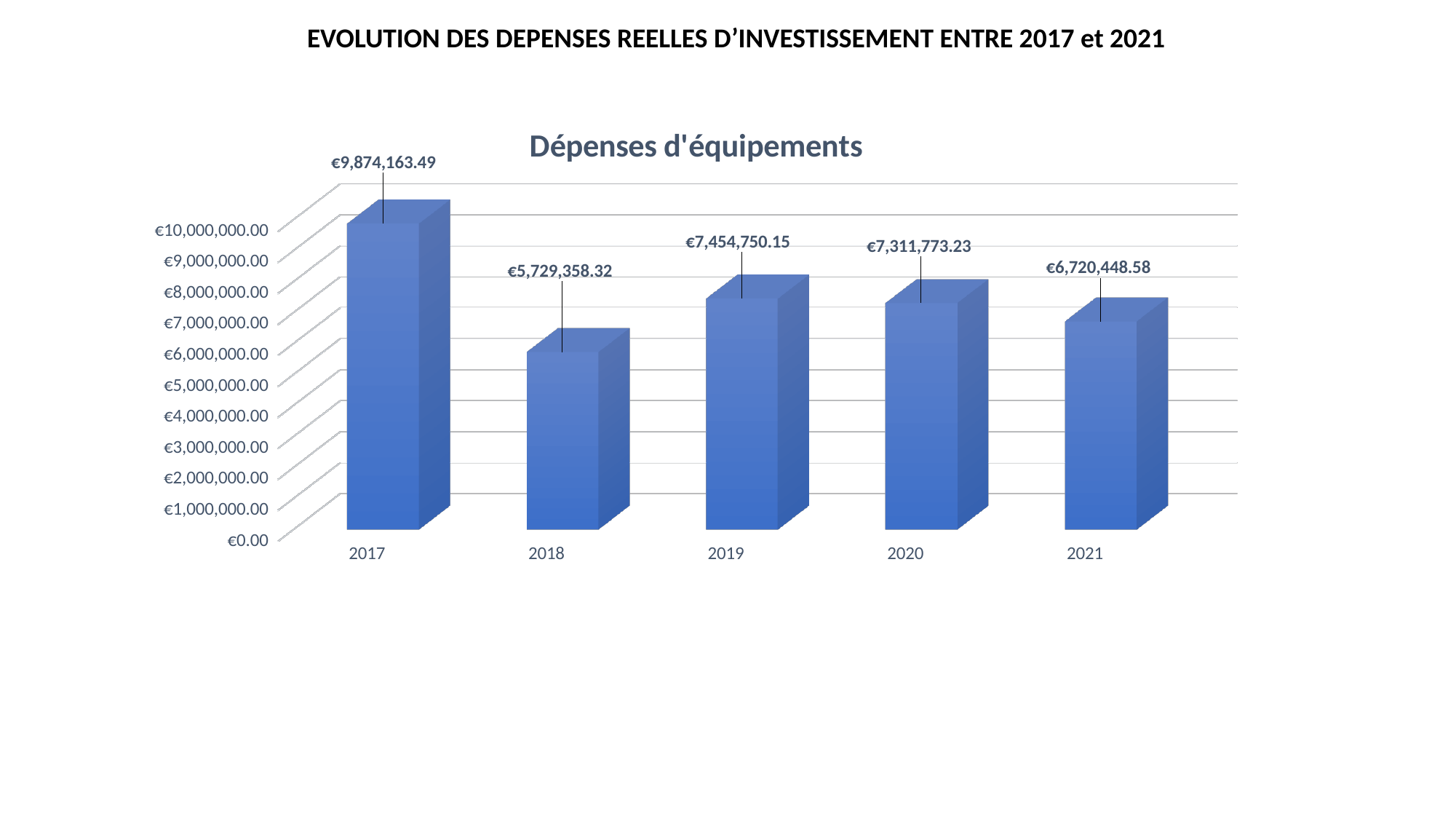
Which year has the lowest value in the Dépenses d'équipements chart? 2018 What is the difference between the values for 2020 and 2021? €591,324.65 What is the value for 2017 in the Dépenses d'équipements chart? €9,874,163.49 What is the value for 2018 in the Dépenses d'équipements chart? €5,729,358.32 Which year has the highest value in the Dépenses d'équipements chart? 2017 How many years are shown on the x axis of the chart? 5 What kind of chart is shown on the slide? bar chart What is the difference between the values for 2017 and 2018? €4,144,805.17 What is the value for 2021 in the Dépenses d'équipements chart? €6,720,448.58 Do the values rise or fall from 2019 to 2021? fall Is the value for 2018 greater or less than €6,000,000.00? less Which is larger, the value for 2019 or the value for 2020? 2019